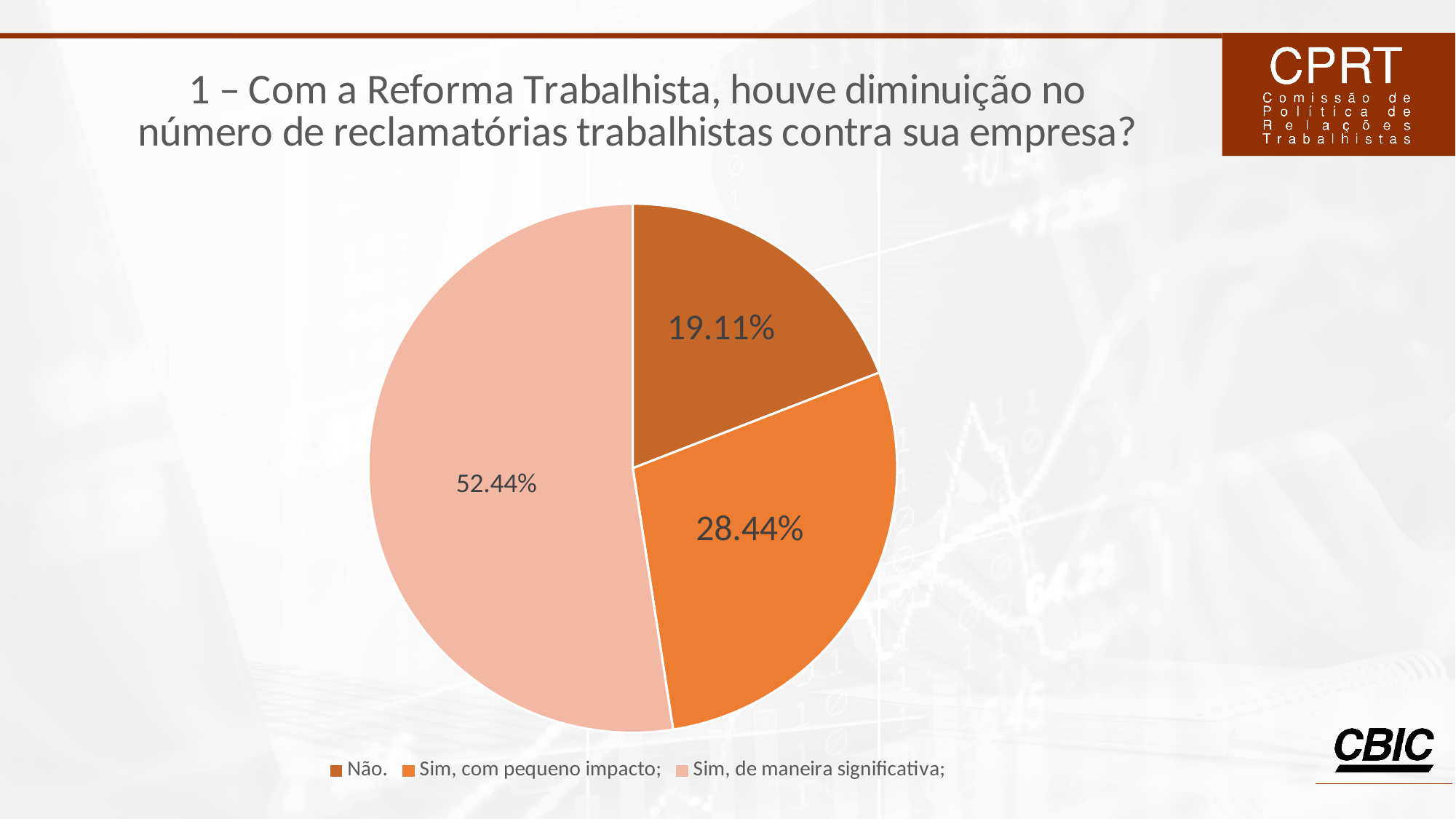
What kind of chart is shown on the slide? pie chart How many entries does the legend list? 3 What is the difference in percentage points between "Sim, com pequeno impacto;" and "Não."? 9.33% Which is larger: the share for "Não." or the share for "Sim, com pequeno impacto;"? Sim, com pequeno impacto; Which response has the largest share of the pie? Sim, de maneira significativa; Which legend entry is shown in the lightest colour? Sim, de maneira significativa; What percentage of respondents answered "Sim, com pequeno impacto;"? 28.44% What percentage of respondents answered "Sim, de maneira significativa;"? 52.44% What percentage of respondents answered "Não."? 19.11% What is the difference in percentage points between "Sim, de maneira significativa;" and "Sim, com pequeno impacto;"? 24.00% How many slices does the pie chart have? 3 Which response has the smallest share of the pie? Não.